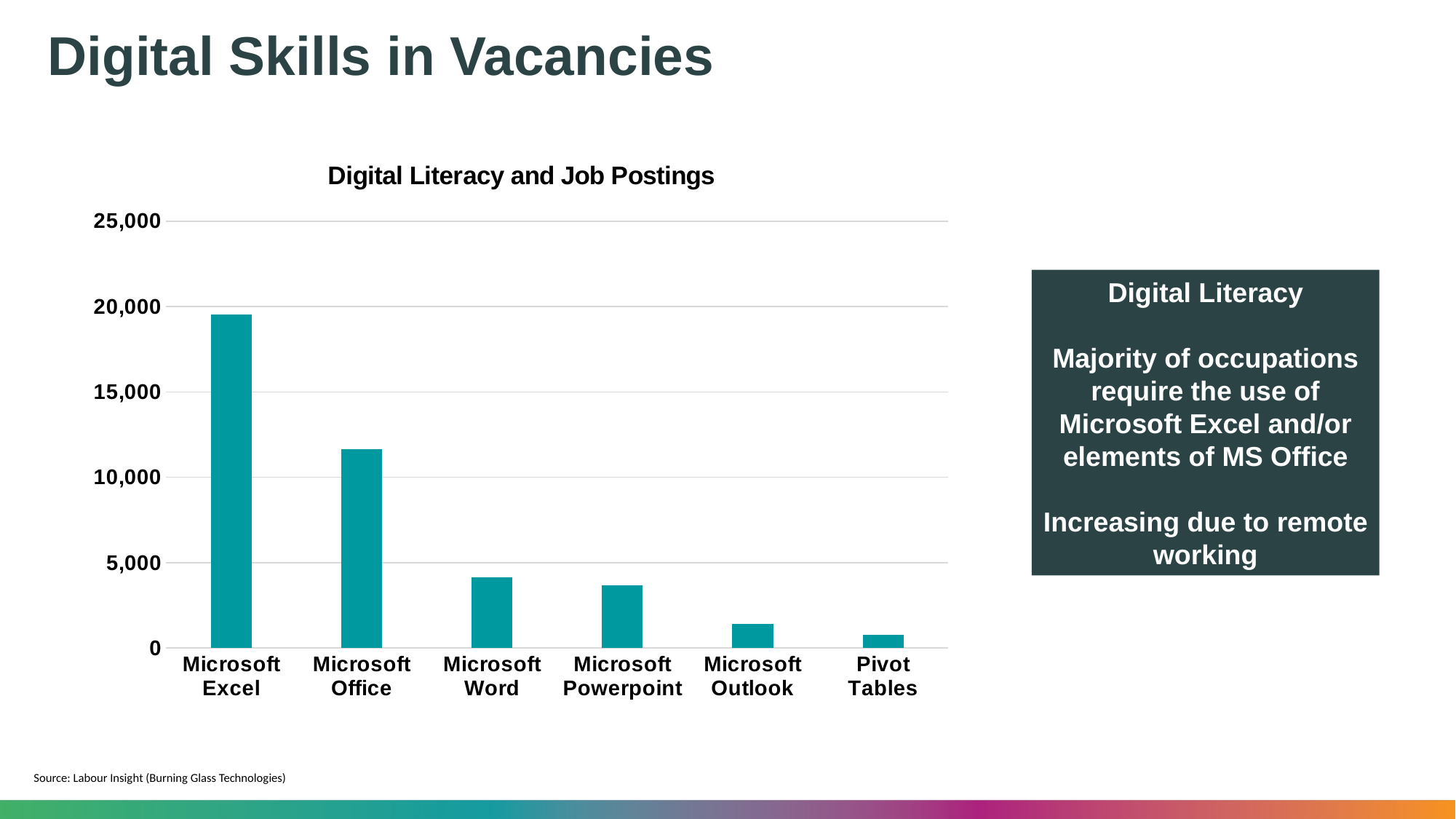
Which category has the lowest value in the chart? Pivot Tables Which category has the highest value in the chart? Microsoft Excel Is the value for Microsoft Outlook greater or less than 5,000? less Which is larger, the value for Microsoft Office or the value for Microsoft Word? Microsoft Office Is the value for Microsoft Excel greater or less than 15,000? greater Is the value for Microsoft Office greater or less than 10,000? greater What is the title of the chart? Digital Literacy and Job Postings Do the values rise or fall moving from left to right along the x axis? fall How many categories are shown on the x axis of the chart? 6 What type of chart is shown on the slide? bar chart Which is larger, the value for Microsoft Outlook or the value for Pivot Tables? Microsoft Outlook